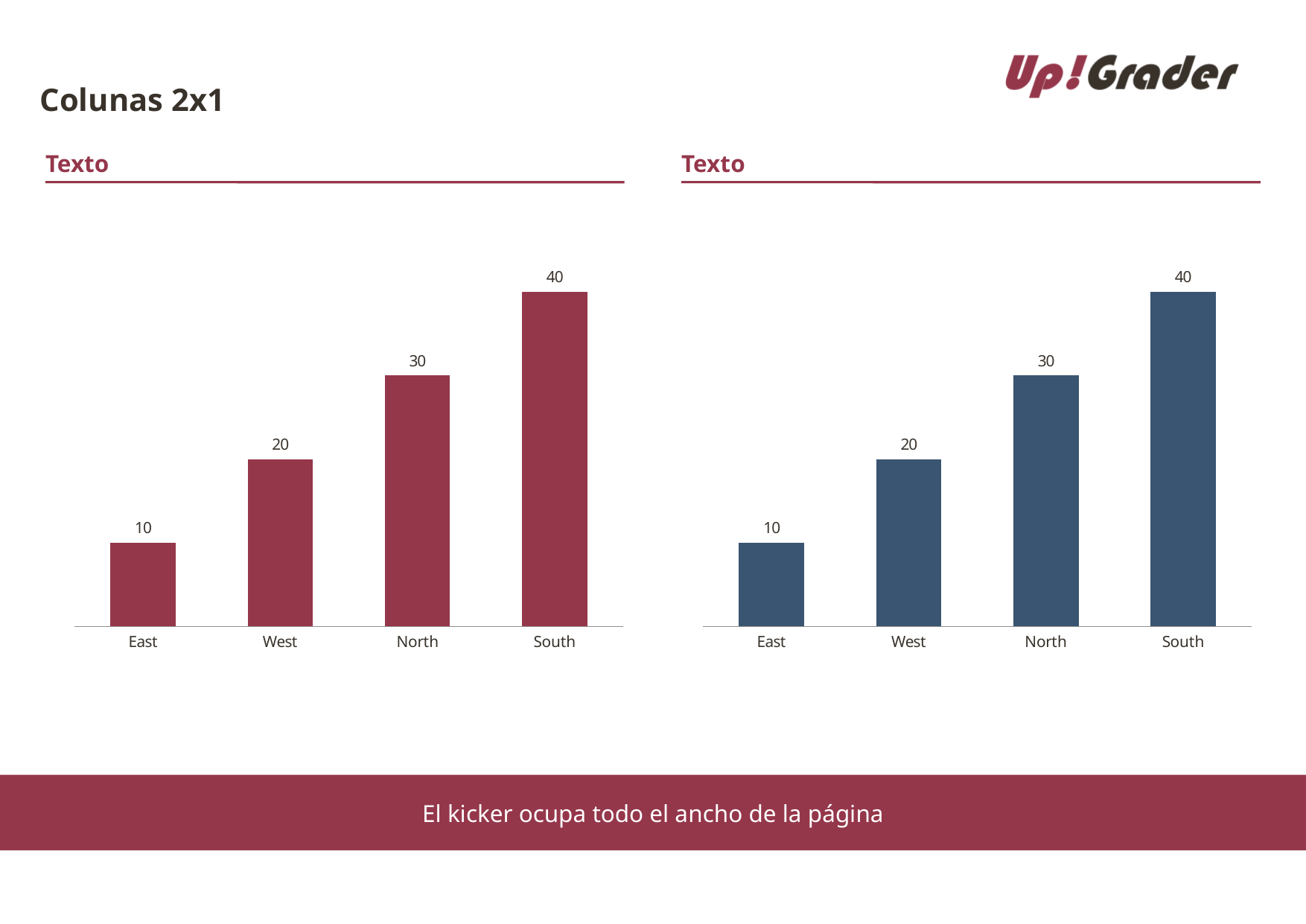
In the right chart, which category has the lowest value? East How many categories are shown in the right chart? 4 What colour are the bars in the right chart? Blue In the right chart, what is the value for North? 30 In the left chart, what is the value for West? 20 In the left chart, which is larger, the value for North or the value for West? North In the left chart, what is the difference between the values for South and East? 30 In the left chart, which category has the highest value? South What kind of chart is the left chart? Bar chart In the right chart, do the values rise or fall from East to South? Rise In the right chart, what is the difference between the values for North and West? 10 In the left chart, what is the value for East? 10